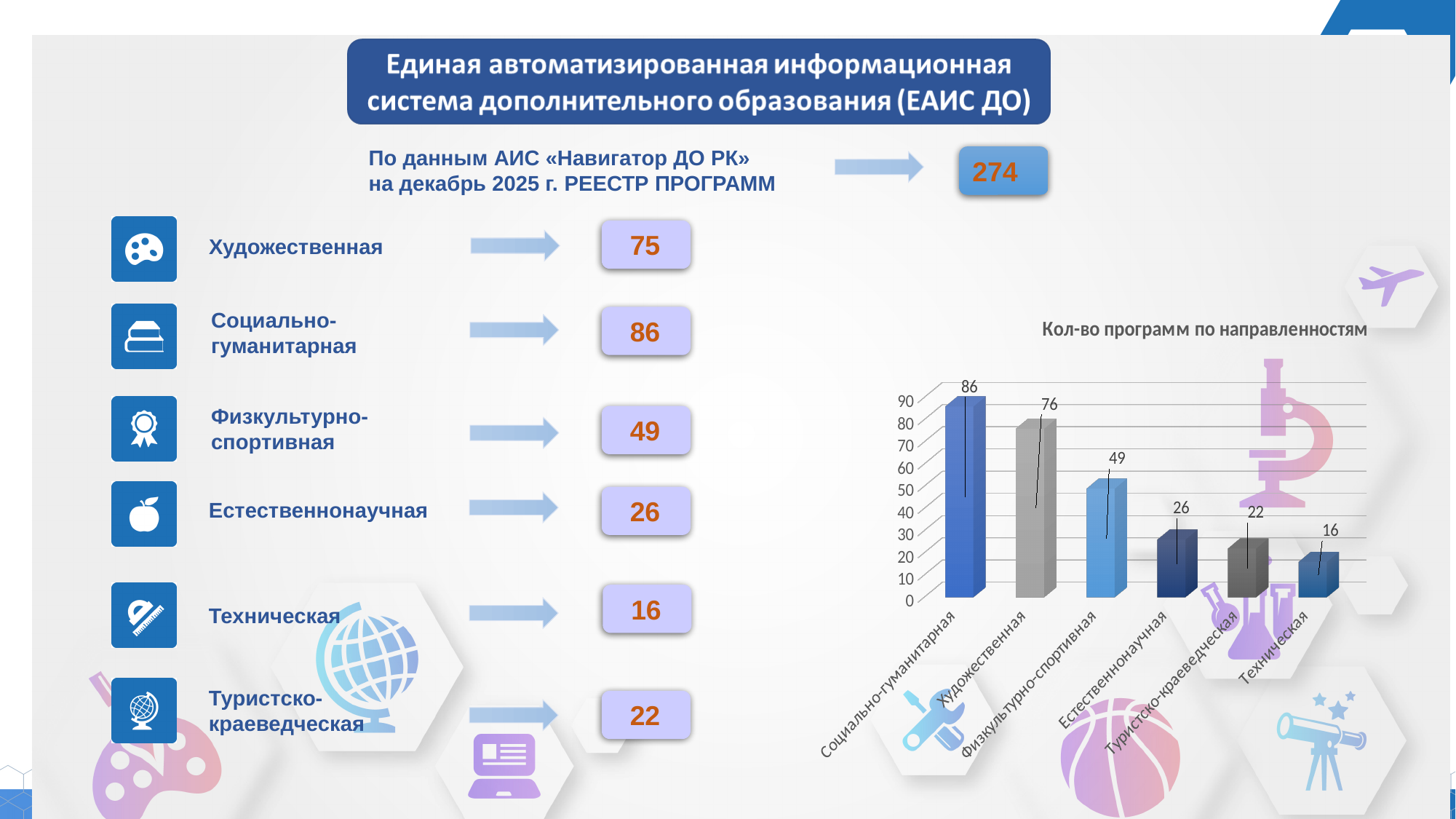
What is the value for Физкультурно-спортивная in the chart? 49 What is the value for Художественная in the chart? 76 What is the title of the chart? Кол-во программ по направленностям What is the value for Техническая in the chart? 16 Which is larger in the chart: Естественнонаучная or Туристско-краеведческая? Естественнонаучная Do the values rise or fall from left to right along the x axis of the chart? fall Which category has the lowest value in the chart? Техническая What is the value for Социально-гуманитарная in the chart? 86 What type of chart is shown on the slide? bar chart What is the difference between the values for Социально-гуманитарная and Естественнонаучная in the chart? 60 How many categories are plotted in the chart? 6 Which category has the highest value in the chart? Социально-гуманитарная